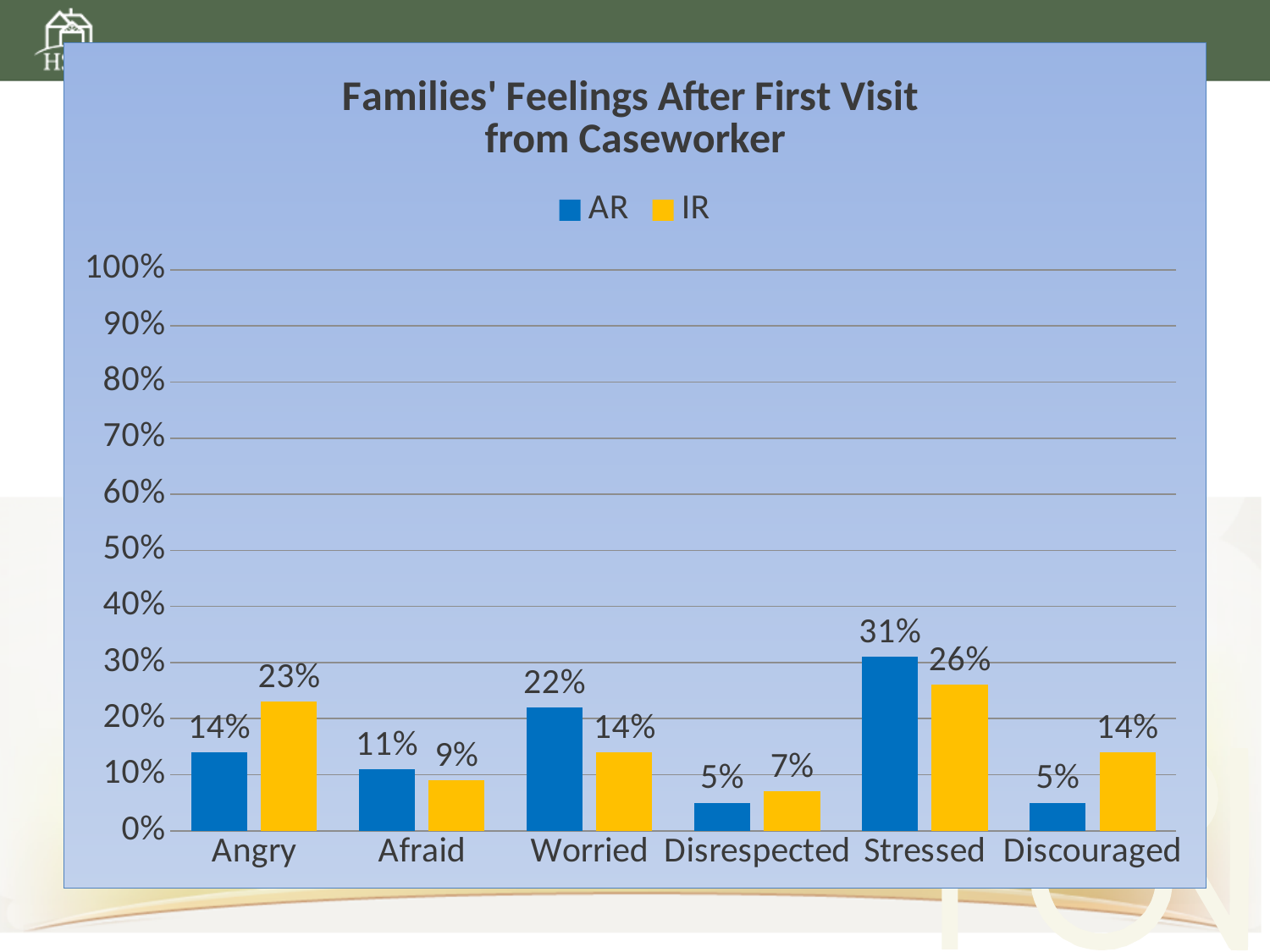
What is the AR value for Worried? 22% What is the difference between the AR and IR values for Worried? 8% How many series does the legend list? 2 Which is larger for Afraid, the AR value or the IR value? AR Which category has the lowest IR value? Disrespected What is the AR value for Stressed? 31% What is the IR value for Angry? 23% How many categories are shown on the x axis? 6 What is the title of the chart? Families' Feelings After First Visit from Caseworker Which category has the highest AR value? Stressed What is the IR value for Discouraged? 14% What kind of chart is shown on the slide? Bar chart